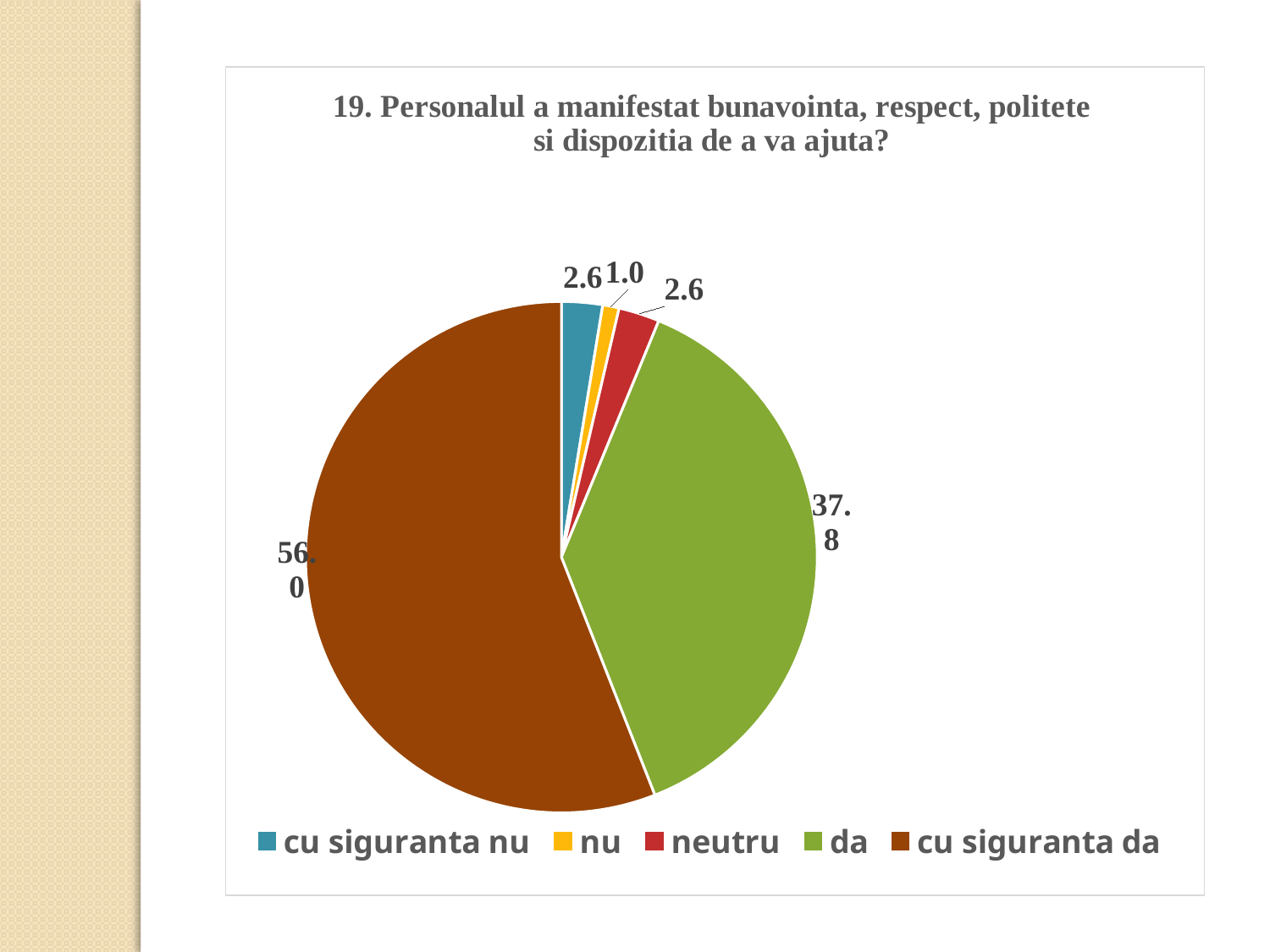
Which colour represents 'neutru' in the legend? red How many categories does the pie chart have? 5 Which category has the largest slice of the pie? cu siguranta da What is the value for 'nu'? 1.0 What is the value for 'cu siguranta da'? 56.0 What is the difference between the values for 'cu siguranta da' and 'da'? 18.2 What is the value for 'da'? 37.8 What is the value for 'neutru'? 2.6 Which is larger, the value for 'cu siguranta nu' or the value for 'nu'? cu siguranta nu Which category has the smallest slice of the pie? nu What is the combined value of 'da' and 'cu siguranta da'? 93.8 What kind of chart is shown on the slide? pie chart